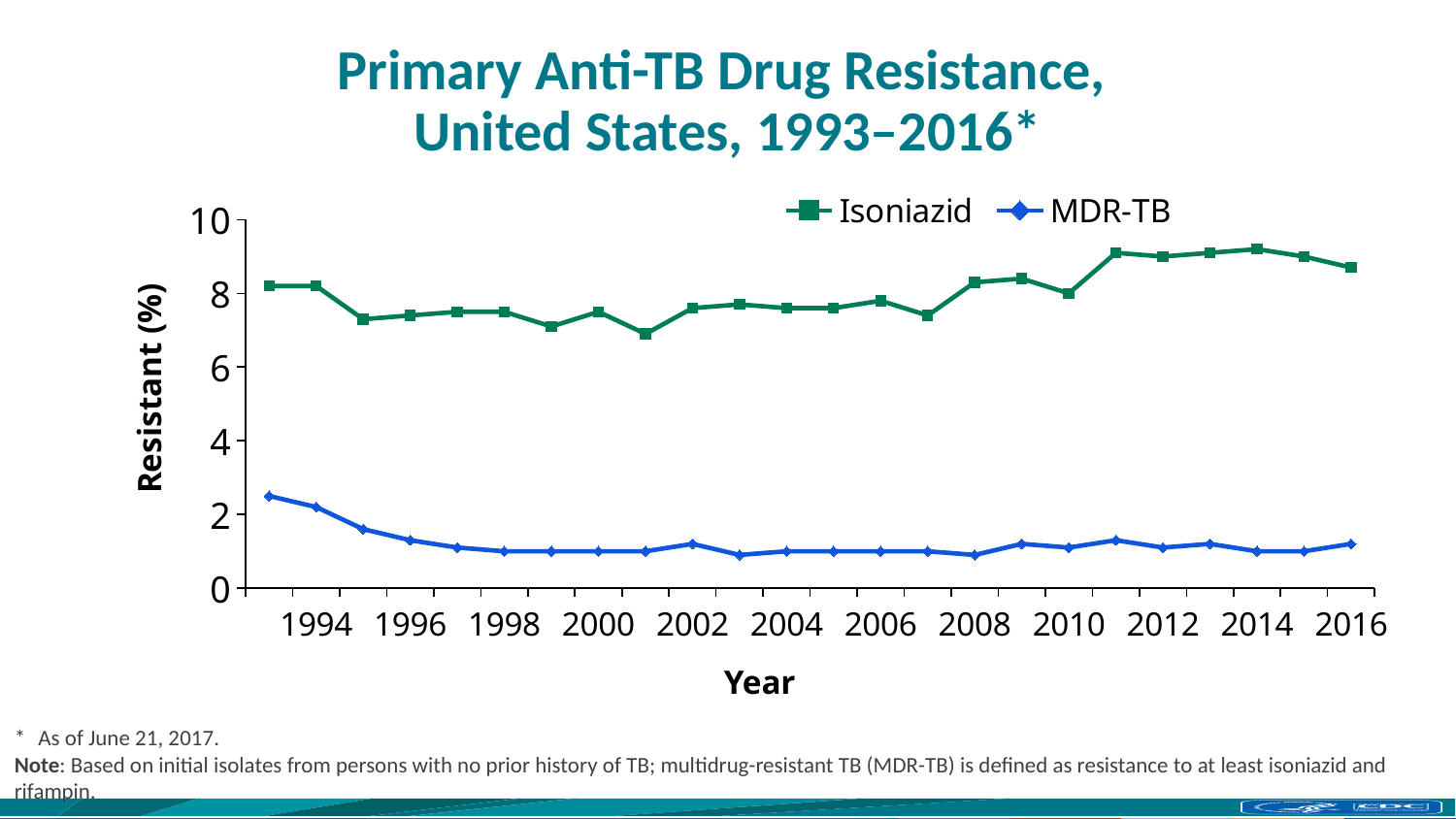
Does the MDR-TB line rise or fall from 1993 to 1998? Fall What kind of chart is shown on the slide? Line chart How many years (data points per series) are plotted, from 1993 to 2016? 24 In 2016, which series has the larger value, Isoniazid or MDR-TB? Isoniazid Is the Isoniazid value for 2014 greater or less than 8? greater Is the MDR-TB value for 1993 greater or less than 2? greater Is the MDR-TB value for 2008 greater or less than 2? less In which year is the MDR-TB value highest? 1993 What is the label of the y axis? Resistant (%) Which two series are shown in the legend? Isoniazid and MDR-TB How many series does the legend list? 2